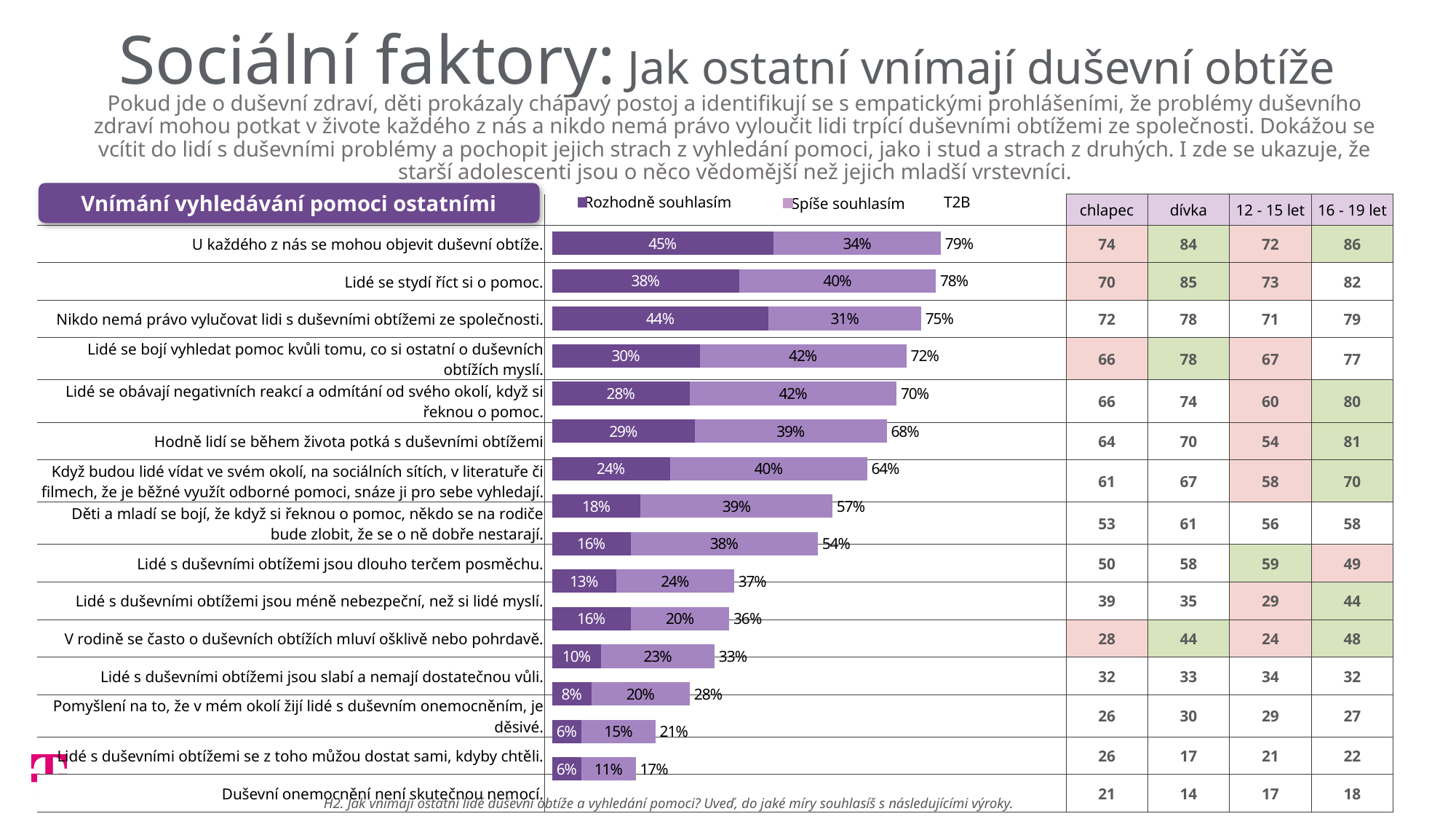
How many statements (categories) are plotted in the chart? 15 What is the difference in 'Rozhodně souhlasím' between 'U každého z nás se mohou objevit duševní obtíže.' and 'Lidé se stydí říct si o pomoc.'? 7 percentage points Do the T2B values rise or fall going from the top statement to the bottom statement? fall Which colour represents 'Rozhodně souhlasím' in the chart? dark purple What is the 'Rozhodně souhlasím' value for 'U každého z nás se mohou objevit duševní obtíže.'? 45% What kind of chart is shown on the slide? bar chart Which has the larger 'Spíše souhlasím' value: 'Lidé se bojí vyhledat pomoc kvůli tomu, co si ostatní o duševních obtížích myslí.' or 'Nikdo nemá právo vylučovat lidi s duševními obtížemi ze společnosti.'? Lidé se bojí vyhledat pomoc kvůli tomu, co si ostatní o duševních obtížích myslí. What is the T2B total for 'Nikdo nemá právo vylučovat lidi s duševními obtížemi ze společnosti.'? 75% Which statement has the highest T2B value? U každého z nás se mohou objevit duševní obtíže. Which statement has the lowest T2B value? Duševní onemocnění není skutečnou nemocí. How many series does the chart legend list? 2 What is the 'Spíše souhlasím' value for 'Lidé se stydí říct si o pomoc.'? 40%